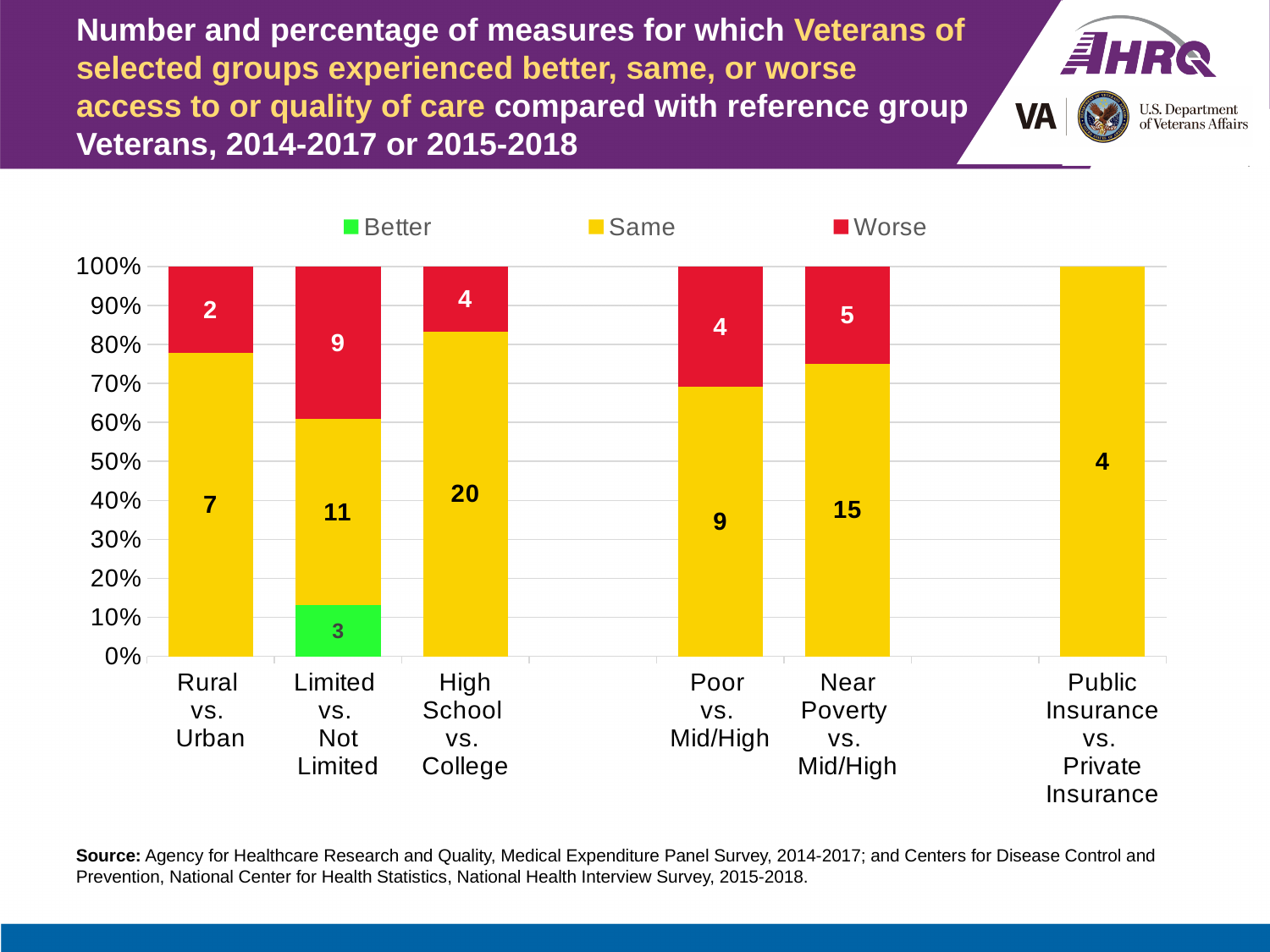
Which has more "Worse" measures: Near Poverty vs. Mid/High or High School vs. College? Near Poverty vs. Mid/High Which group has the lowest number of "Worse" measures among those with a Worse segment? Rural vs. Urban What kind of chart is shown on the slide? Stacked bar chart Which group has the highest number of "Same" measures? High School vs. College How many measures are labeled "Worse" for the Limited vs. Not Limited group? 9 How many measures are labeled "Better" for the Limited vs. Not Limited group? 3 What is the difference between the number of "Same" measures for Near Poverty vs. Mid/High and Poor vs. Mid/High? 6 How many comparison groups are shown on the x axis? 6 How many measures are labeled "Same" for the Public Insurance vs. Private Insurance group? 4 What is the total number of measures for the Limited vs. Not Limited group? 23 How many measures are labeled "Same" for the Rural vs. Urban group? 7 How many series does the legend list? 3